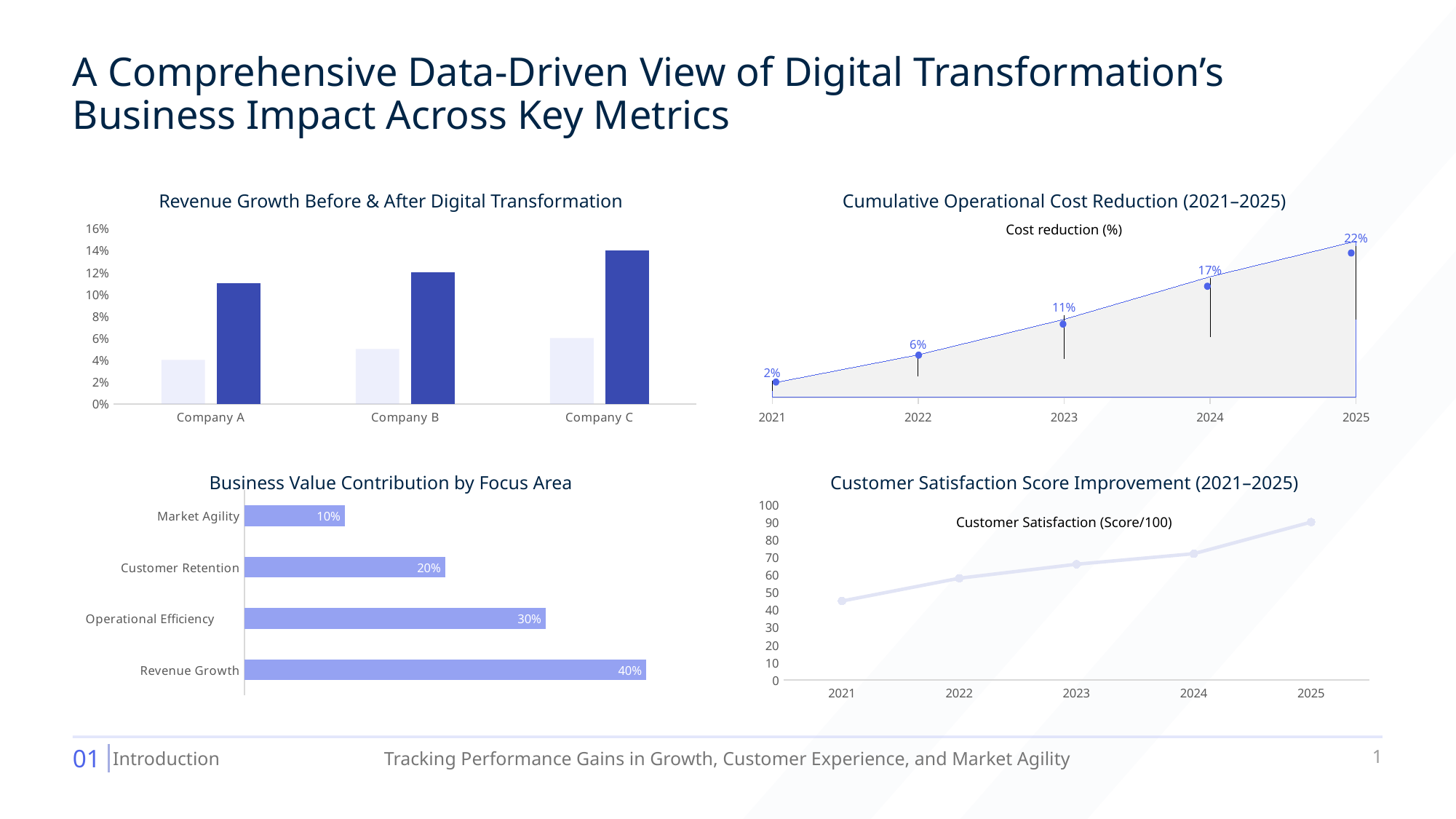
In the 'Revenue Growth Before & After Digital Transformation' chart, is the darker bar for Company C greater or less than 12%? greater In the 'Revenue Growth Before & After Digital Transformation' chart, how many companies are shown? 3 What kind of chart is 'Business Value Contribution by Focus Area'? bar chart In the 'Business Value Contribution by Focus Area' chart, which focus area has the lowest value? Market Agility In the 'Cumulative Operational Cost Reduction (2021–2025)' chart, what is the difference between the 2024 and 2022 values? 11% In the 'Business Value Contribution by Focus Area' chart, which focus area has the highest value? Revenue Growth In the 'Cumulative Operational Cost Reduction (2021–2025)' chart, what is the cost reduction value for 2025? 22% In the 'Cumulative Operational Cost Reduction (2021–2025)' chart, what is the cost reduction value for 2023? 11% In the 'Customer Satisfaction Score Improvement (2021–2025)' chart, is the value for 2021 greater or less than 50? less In the 'Business Value Contribution by Focus Area' chart, what is the difference between Revenue Growth and Customer Retention? 20% In the 'Cumulative Operational Cost Reduction (2021–2025)' chart, do the values rise or fall from 2021 to 2025? rise In the 'Business Value Contribution by Focus Area' chart, what is the value for Operational Efficiency? 30%